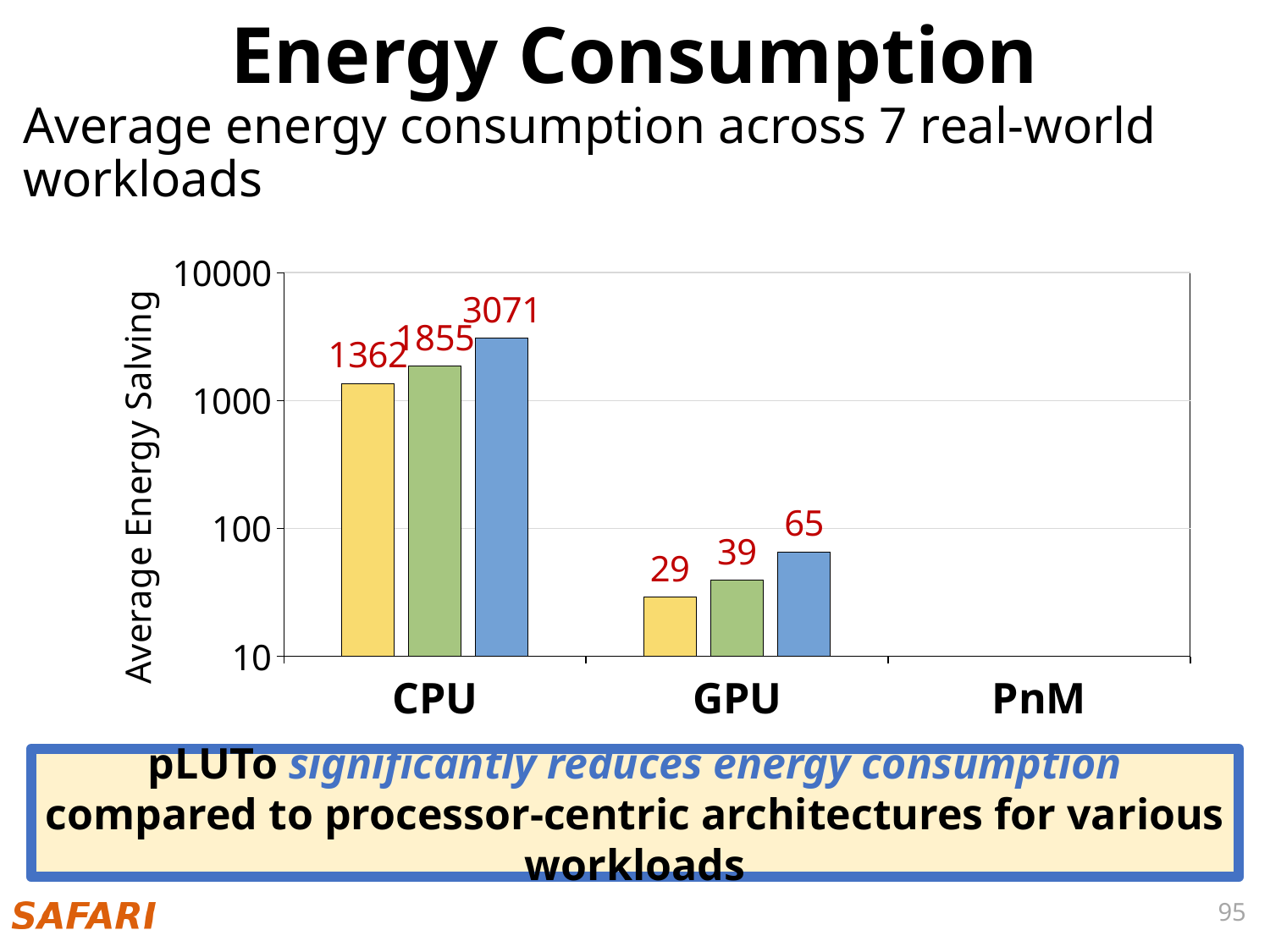
What is the value of the green (second) bar for GPU? 39 What is the value of the green (second) bar for CPU? 1855 What is the label of the y axis? Average Energy Salving What is the value of the blue (third) bar for CPU? 3071 Which of the three CPU bars has the highest value? the blue (third) bar, 3071 Which of the three GPU bars has the lowest value? the yellow (first) bar, 29 How many categories are labelled on the x axis? 3 What is the value of the yellow (first) bar for GPU? 29 What is the difference between the blue bar for CPU and the yellow bar for CPU? 1709 Which is larger, the yellow bar for CPU or the blue bar for GPU? the yellow bar for CPU (1362) What is the difference between the blue bar for GPU and the green bar for GPU? 26 What kind of chart is shown on the slide? bar chart